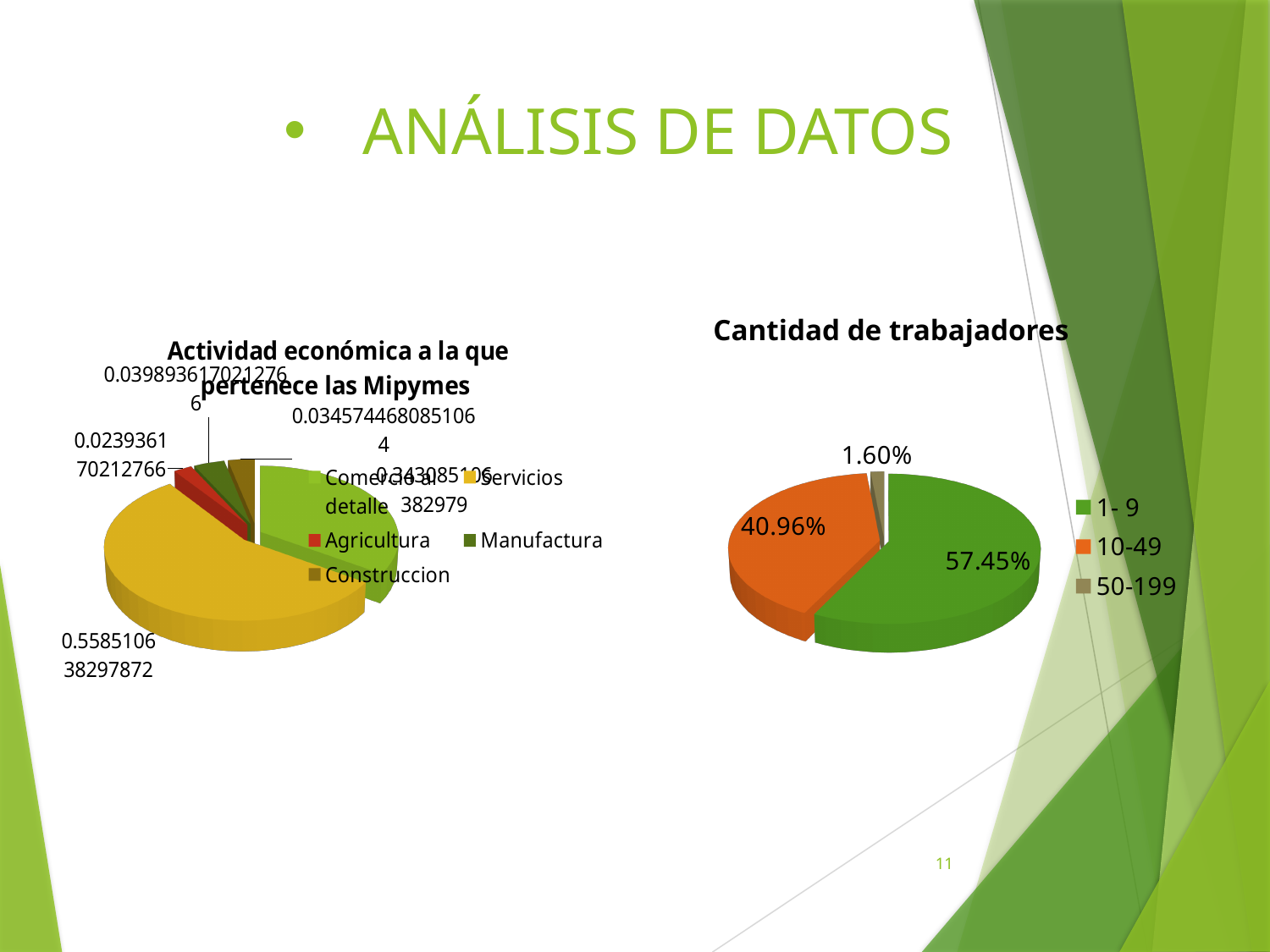
In the 'Cantidad de trabajadores' chart, what percentage is shown for the 1- 9 category? 57.45% In the 'Cantidad de trabajadores' chart, which category has the smallest share? 50-199 In the 'Cantidad de trabajadores' chart, what is the difference in percentage points between the 1- 9 and 10-49 categories? 16.49 In the 'Cantidad de trabajadores' chart, what percentage is shown for the 50-199 category? 1.60% In the 'Cantidad de trabajadores' chart, which category has the largest share? 1- 9 In the 'Actividad económica a la que pertenece las Mipymes' chart, which category has the largest slice? Servicios In the 'Cantidad de trabajadores' chart, what percentage is shown for the 10-49 category? 40.96% In the 'Cantidad de trabajadores' chart, what is the difference in percentage points between the 10-49 and 50-199 categories? 39.36 How many categories does the legend of the 'Actividad económica a la que pertenece las Mipymes' chart list? 5 What type of chart is the 'Cantidad de trabajadores' chart? Pie chart How many categories does the legend of the 'Cantidad de trabajadores' chart list? 3 In the 'Cantidad de trabajadores' chart, which is larger: the share for 10-49 or the share for 50-199? 10-49